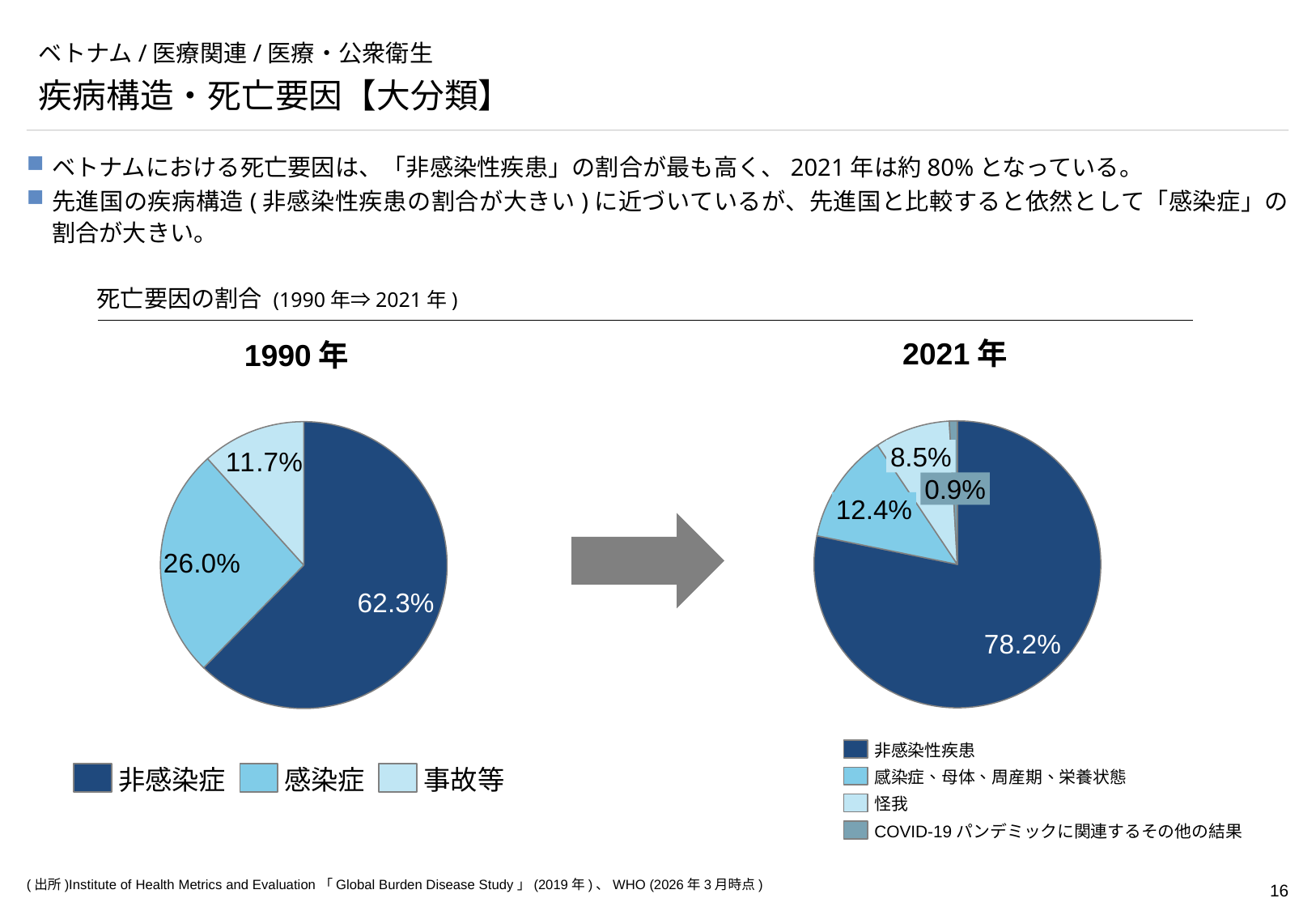
In the 1990年 pie chart, what share is shown for 感染症? 26.0% What type of chart is used for the 1990年 chart? pie chart In the 2021年 pie chart, what share is shown for 非感染性疾患? 78.2% In the 1990年 pie chart, what share is shown for 事故等? 11.7% In the 1990年 pie chart, what share is shown for 非感染症? 62.3% Which is larger: the 非感染症 share in the 1990年 chart or the 非感染性疾患 share in the 2021年 chart? 2021年 (78.2%) In the 2021年 pie chart, which category has the smallest share? COVID-19 パンデミックに関連するその他の結果 In the 1990年 pie chart, what is the difference between the shares of 感染症 and 事故等? 14.3% In the 2021年 pie chart, what share is shown for 怪我? 8.5% In the 2021年 pie chart, what share is shown for COVID-19 パンデミックに関連するその他の結果? 0.9% In the 1990年 pie chart, which category has the largest share? 非感染症 How many categories does the legend of the 2021年 pie chart list? 4